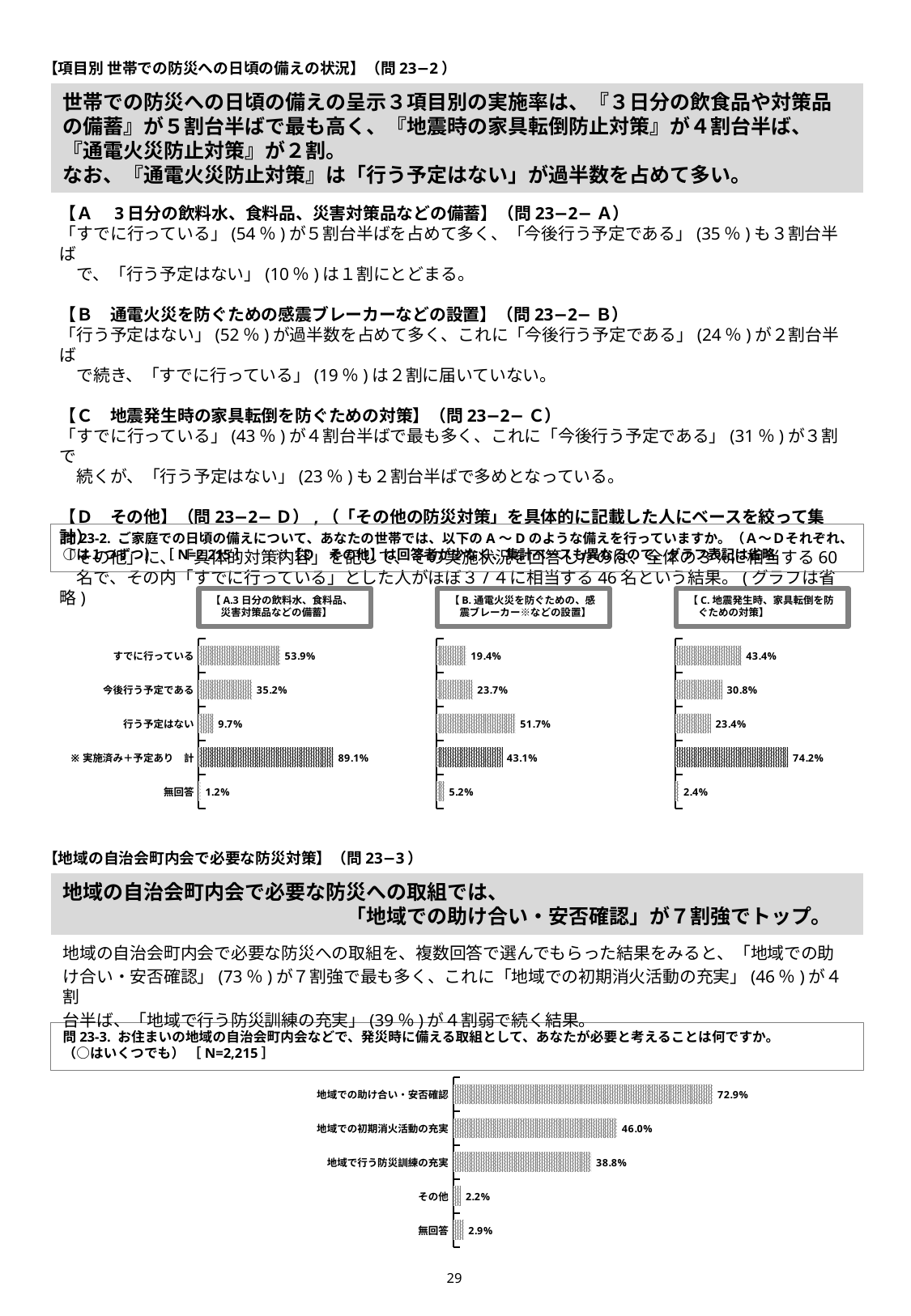
In the chart for 問23-3 (地域の自治会町内会), how many categories are shown? 5 In the chart 【C.地震発生時、家具転倒を防ぐための対策】, what is the value for 今後行う予定である? 30.8% In the chart 【A.3日分の飲料水、食料品、災害対策品などの備蓄】, what is the value for すでに行っている? 53.9% In the chart 【B.通電火災を防ぐための、感震ブレーカー※などの設置】, which category has the highest value? 行う予定はない What type of chart is used for 問23-3 (地域の自治会町内会)? Bar chart In the chart for 問23-3 (地域の自治会町内会), what is the difference between 地域での助け合い・安否確認 and 地域で行う防災訓練の充実? 34.1% In the chart 【C.地震発生時、家具転倒を防ぐための対策】, what is the difference between すでに行っている and 行う予定はない? 20.0% In the chart for 問23-3 (地域の自治会町内会), what is the value for 地域での初期消火活動の充実? 46.0% In the chart 【B.通電火災を防ぐための、感震ブレーカー※などの設置】, what is the value for 行う予定はない? 51.7% Which is larger: すでに行っている in chart 【A.3日分の飲料水、食料品、災害対策品などの備蓄】 or すでに行っている in chart 【C.地震発生時、家具転倒を防ぐための対策】? Chart A (53.9%) In the chart 【A.3日分の飲料水、食料品、災害対策品などの備蓄】, which category has the lowest value? 無回答 In the chart for 問23-3 (地域の自治会町内会), which category has the highest value? 地域での助け合い・安否確認